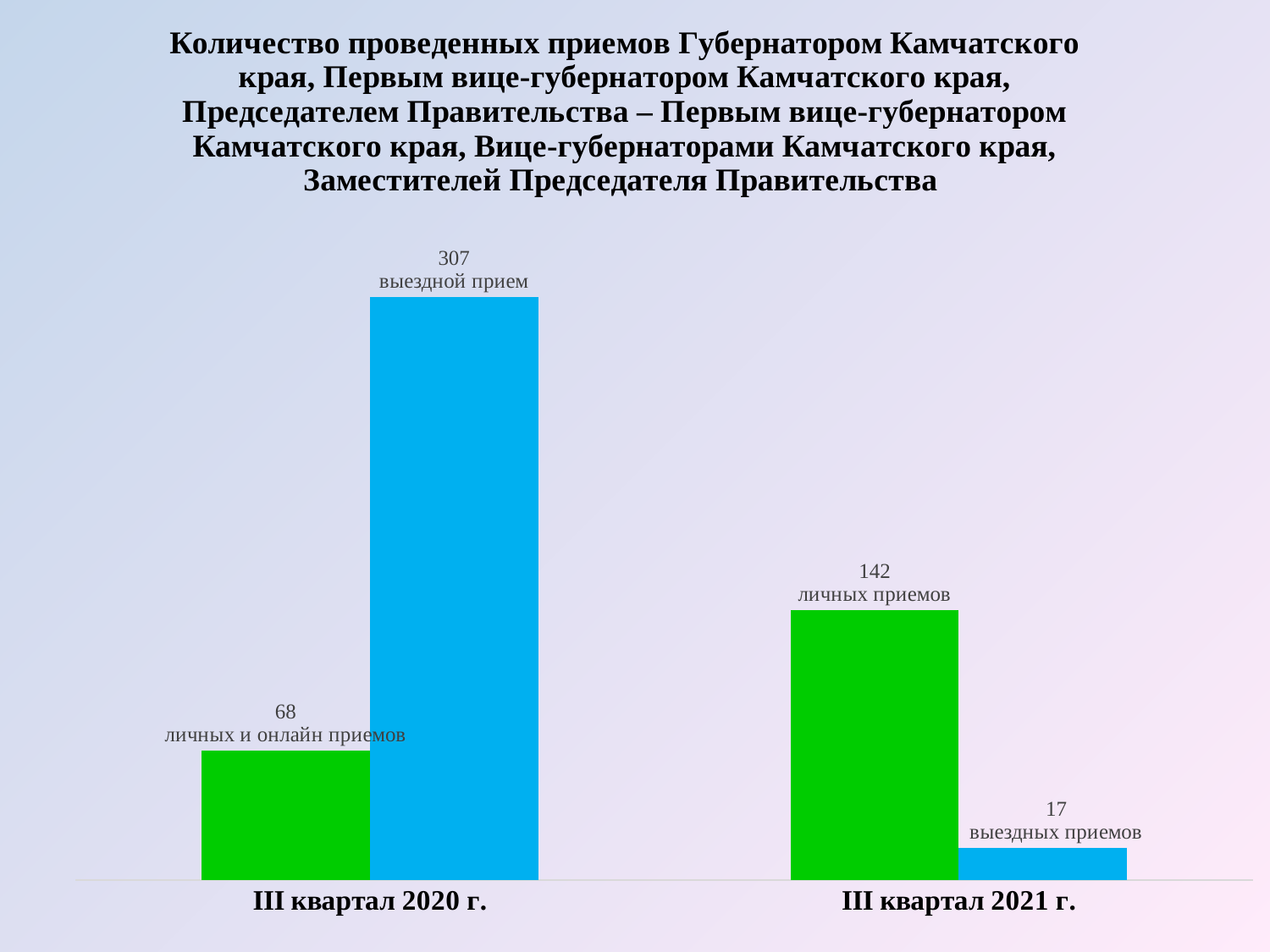
How many on-site receptions (выездных приемов) were held in III квартал 2021 г.? 17 How many personal receptions (личных приемов) were held in III квартал 2021 г.? 142 What is the difference between the number of personal receptions in III квартал 2021 г. and personal and online receptions in III квартал 2020 г.? 74 What type of chart is shown on the slide? Bar chart What is the difference between the number of on-site receptions in III квартал 2020 г. and in III квартал 2021 г.? 290 How many on-site receptions (выездной прием) were held in III квартал 2020 г.? 307 Which is larger: the number of personal receptions in III квартал 2021 г. or the number of on-site receptions in III квартал 2021 г.? Personal receptions (142) Which bar on the chart has the lowest value? 17 выездных приемов (III квартал 2021 г.) How many quarters (categories) are shown on the x axis of the chart? 2 Which bar on the chart has the highest value? 307 выездной прием (III квартал 2020 г.) How many personal and online receptions (личных и онлайн приемов) were held in III квартал 2020 г.? 68 What colour are the bars representing on-site receptions (выездные приемы)? Blue